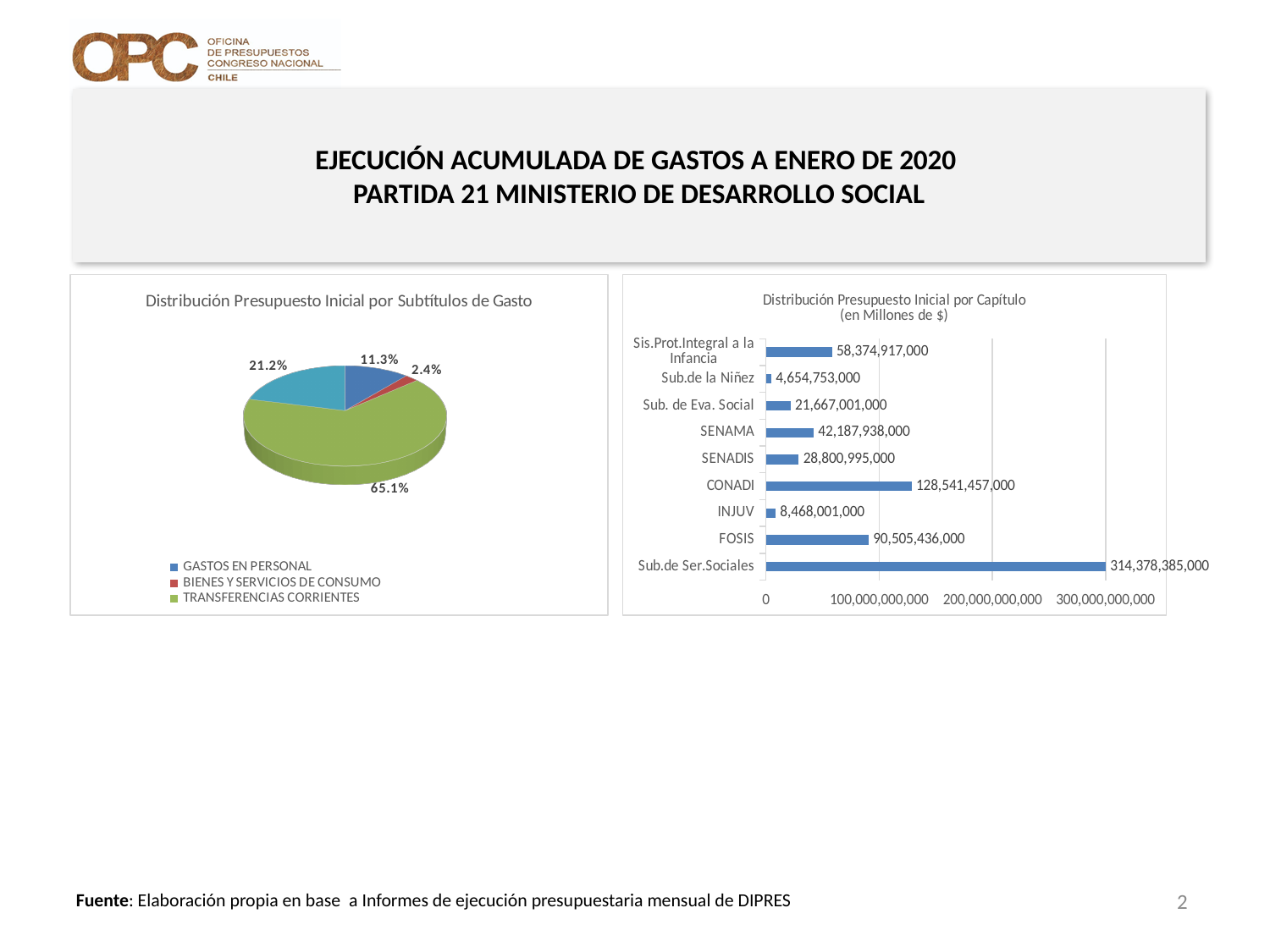
In the chart 'Distribución Presupuesto Inicial por Capítulo', is the value for FOSIS greater or less than 100,000,000,000? less In the chart 'Distribución Presupuesto Inicial por Capítulo', what is the difference between the values for Sub.de Ser.Sociales and CONADI? 185,836,928,000 In the chart 'Distribución Presupuesto Inicial por Capítulo', which capítulo has the lowest value? Sub.de la Niñez What kind of chart is 'Distribución Presupuesto Inicial por Capítulo'? bar chart In the chart 'Distribución Presupuesto Inicial por Subtítulos de Gasto', what share does TRANSFERENCIAS CORRIENTES have? 65.1% In the chart 'Distribución Presupuesto Inicial por Capítulo', what is the value for CONADI? 128,541,457,000 How many capítulos are shown in the chart 'Distribución Presupuesto Inicial por Capítulo'? 9 In the chart 'Distribución Presupuesto Inicial por Capítulo', which is larger, SENAMA or SENADIS? SENAMA In the chart 'Distribución Presupuesto Inicial por Capítulo', what is the value for FOSIS? 90,505,436,000 In the chart 'Distribución Presupuesto Inicial por Subtítulos de Gasto', what share does GASTOS EN PERSONAL have? 11.3% How many entries does the legend list in the chart 'Distribución Presupuesto Inicial por Subtítulos de Gasto'? 3 In the chart 'Distribución Presupuesto Inicial por Capítulo', which capítulo has the highest value? Sub.de Ser.Sociales